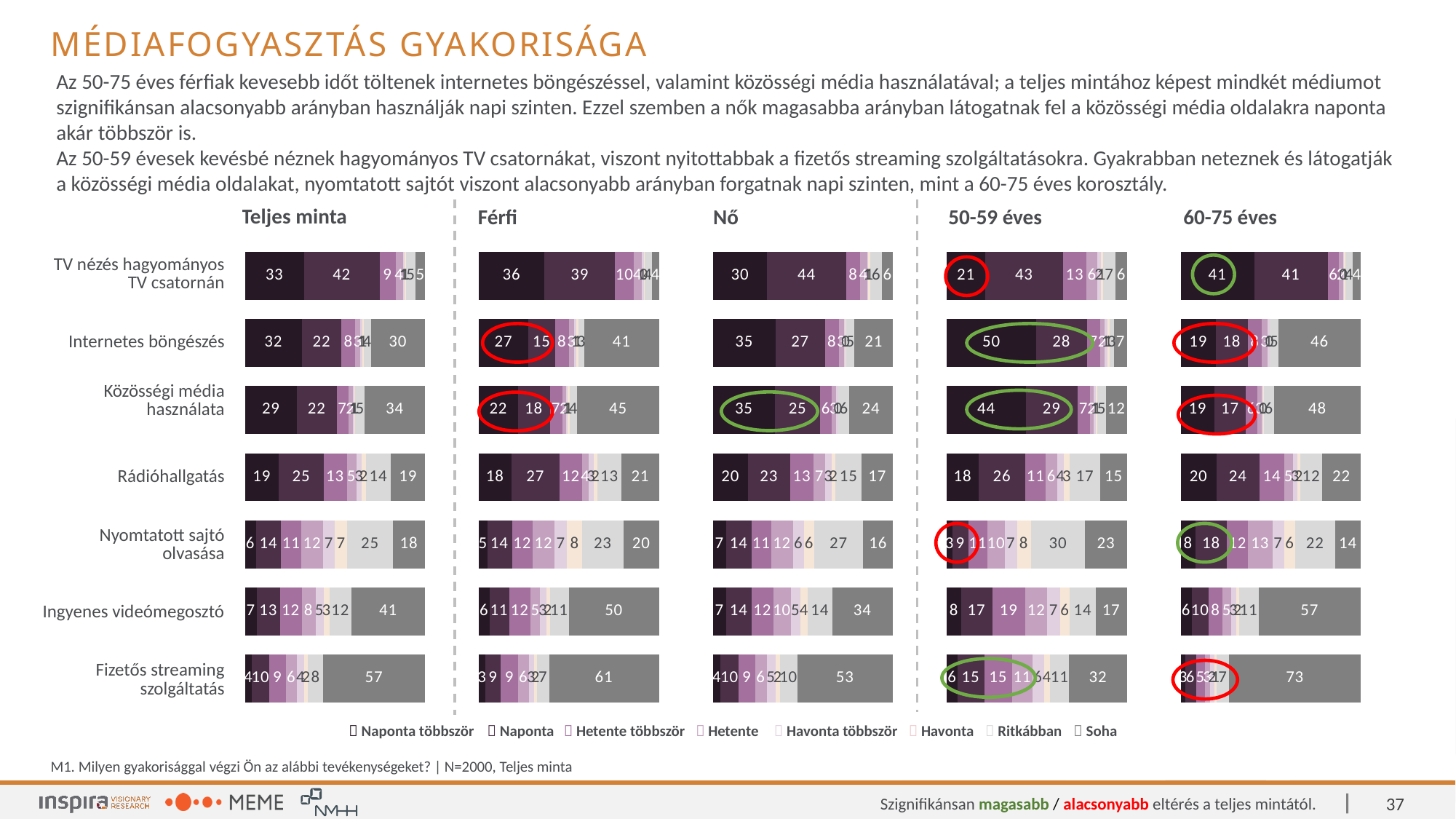
In the 50-59 éves chart, which activity has the highest Naponta többször value? Internetes böngészés In the Teljes minta chart, what is the Naponta többször value for TV nézés hagyományos TV csatornán? 33 How many series does the legend list? 8 In the Férfi chart, what is the Soha value for Ingyenes videómegosztó? 50 How many activity categories are shown in each chart? 7 What kind of chart is used on this slide? Stacked bar chart In the 60-75 éves chart, what is the Soha value for Fizetős streaming szolgáltatás? 73 What is the title of the chart group on the far right of the slide? 60-75 éves In the Férfi chart, what is the difference between the Naponta többször values for Internetes böngészés and Közösségi média használata? 5 In the 50-59 éves chart, what is the Naponta többször value for Internetes böngészés? 50 In the Nő chart, what is the Naponta value for TV nézés hagyományos TV csatornán? 44 In the 60-75 éves chart, which is larger: the Soha value for Közösségi média használata or the Soha value for Internetes böngészés? Közösségi média használata